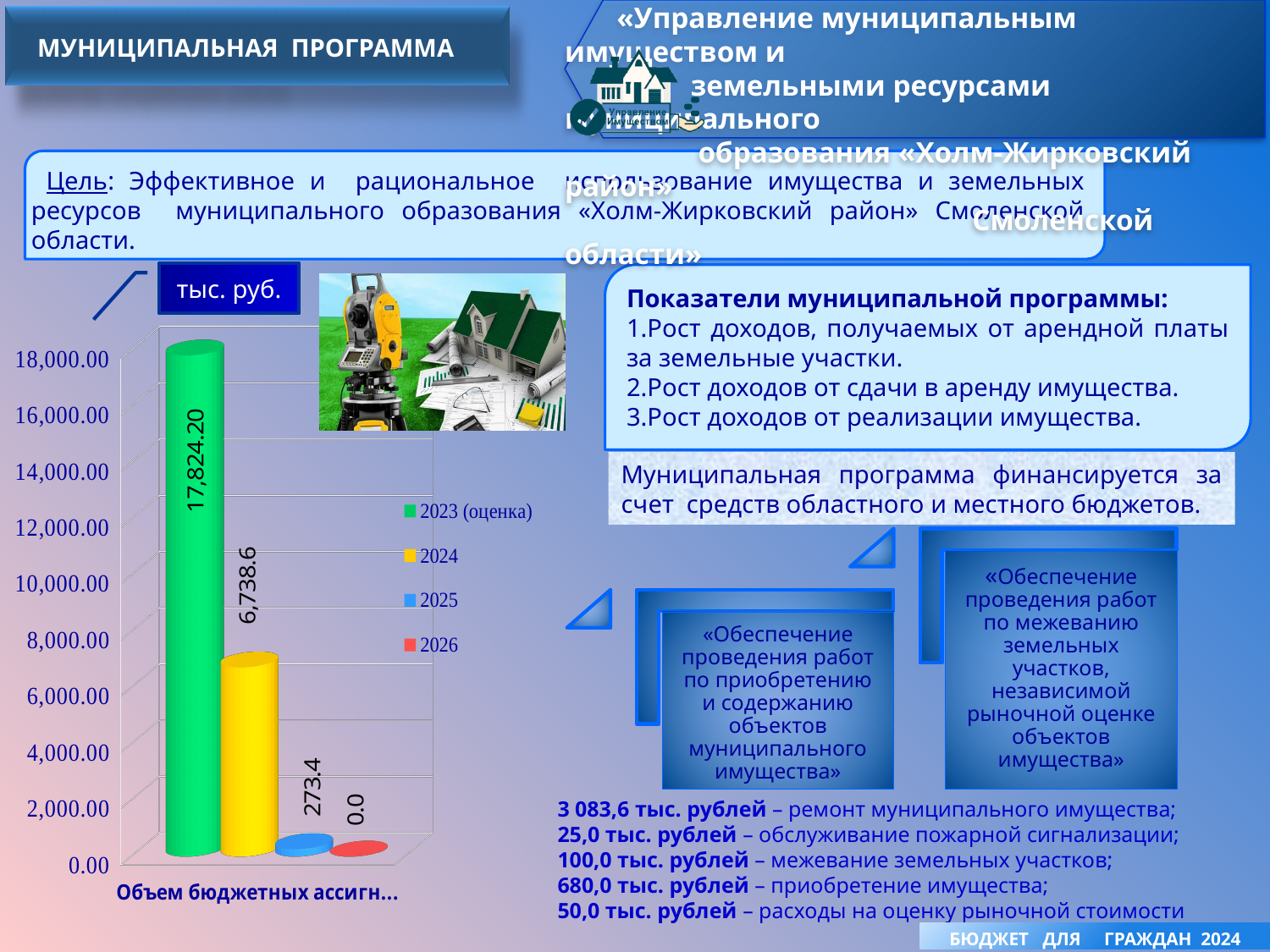
What kind of chart is shown on the slide? bar chart What is the value for 2023 (оценка) in the chart? 17,824.20 What is the value for 2025 in the chart? 273.4 What is the value for 2026 in the chart? 0.0 Which is larger, the value for 2024 or the value for 2025? 2024 How many series does the chart legend list? 4 What unit is shown in the box above the chart? тыс. руб. Which series has the lowest value in the chart? 2026 What is the difference between the values for 2024 and 2025? 6,465.2 Which series has the highest value in the chart? 2023 (оценка) What is the value for 2024 in the chart? 6,738.6 Is the value for 2024 greater or less than 8,000.00? less